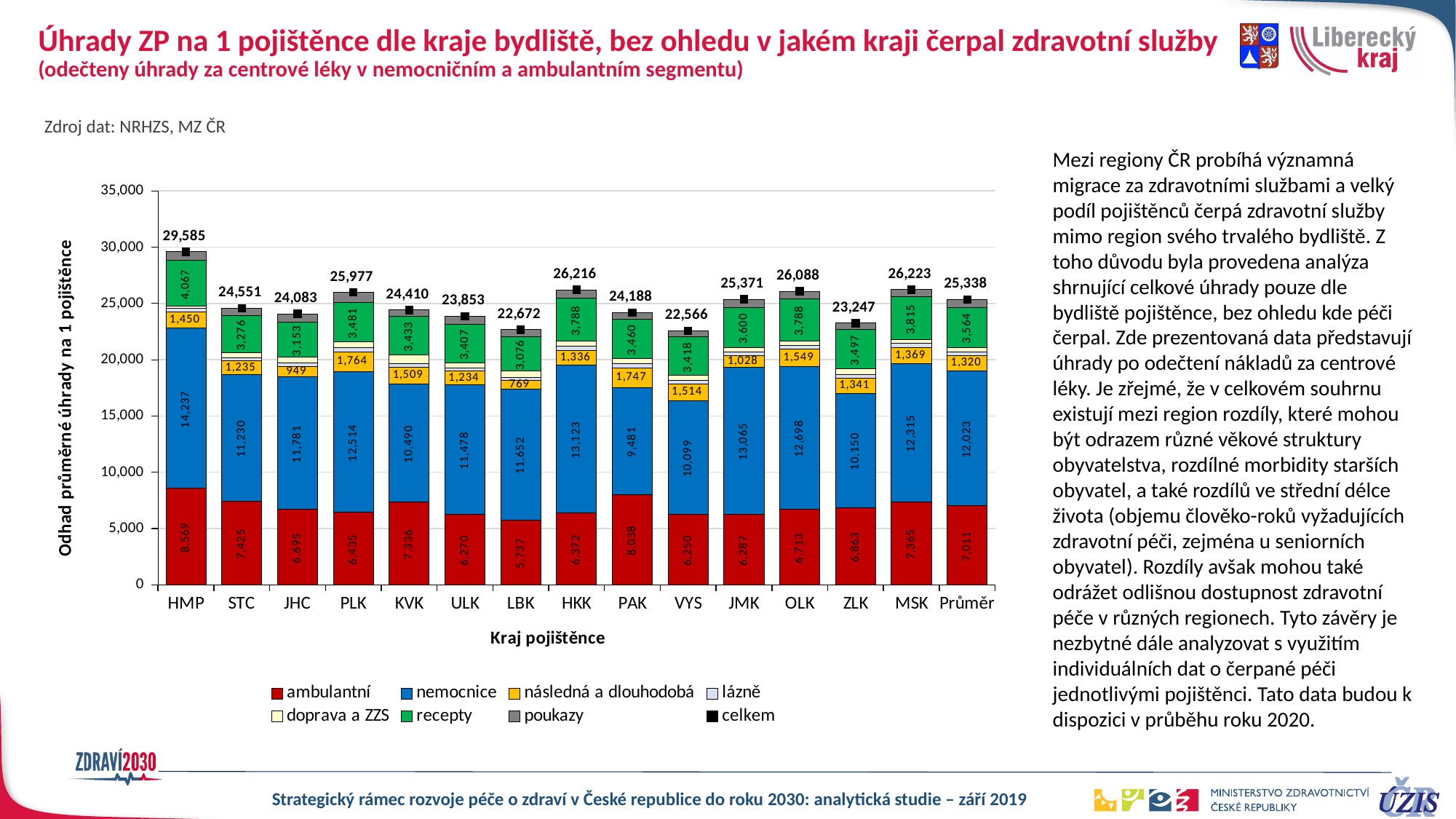
Which is larger, the nemocnice value for HKK or the nemocnice value for KVK? HKK Is the total value for LBK greater or less than 25,000? less What is the recepty value for MSK? 3,815 Which region has the highest total (celkem) value? HMP Which region has the lowest total (celkem) value? VYS How many categories are shown on the x axis? 15 What is the difference between the total for HMP and the total for VYS? 7,019 What is the nemocnice value for PAK? 9,481 What kind of chart is shown on the slide? stacked bar chart What is the ambulantní value for LBK? 5,737 How many series does the legend list? 8 What is the total (celkem) value shown above the bar for HMP? 29,585